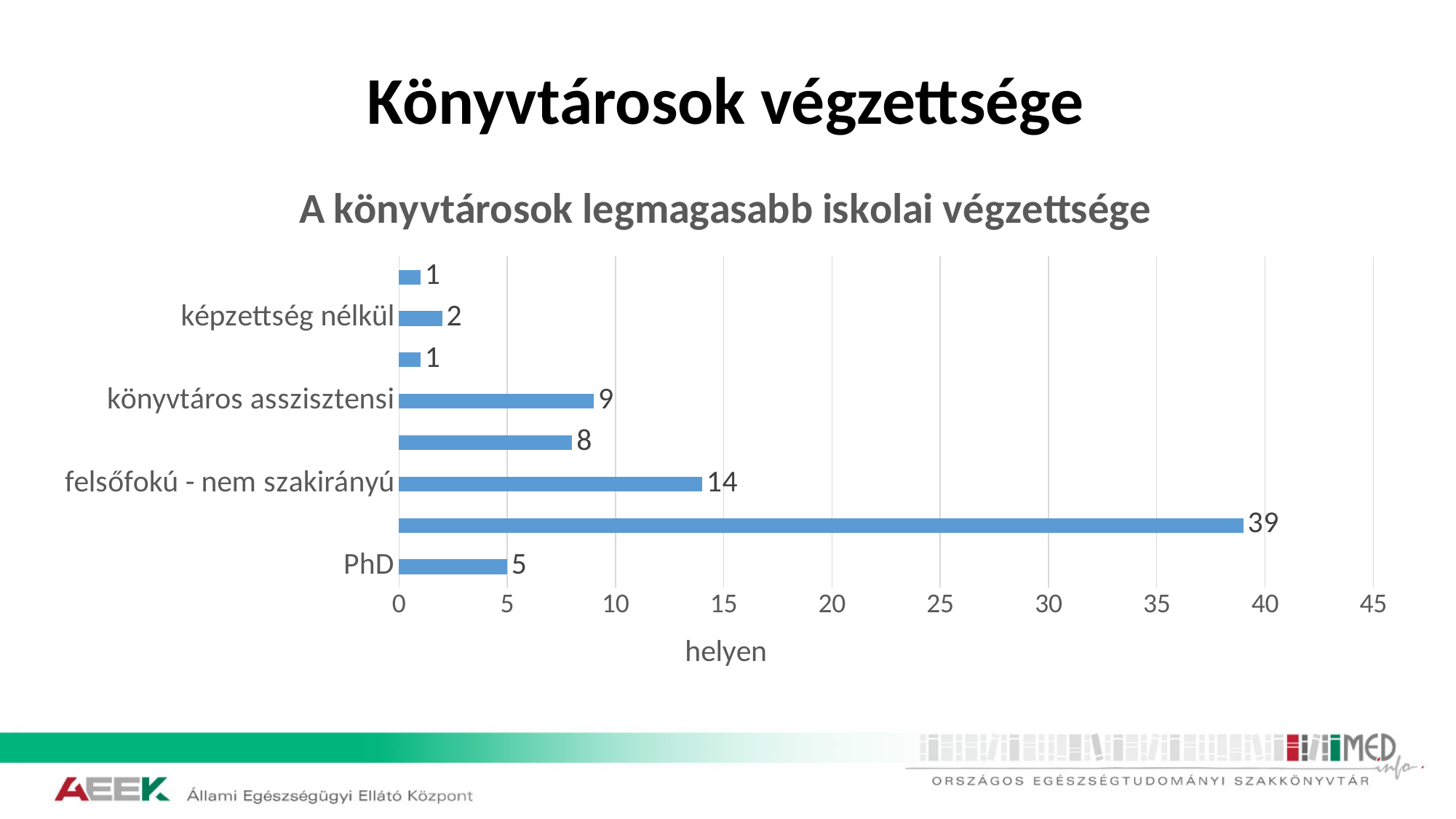
What is the value for könyvtáros asszisztensi? 9 Which is larger, the value for könyvtáros asszisztensi or the value for PhD? könyvtáros asszisztensi What is the title of the chart? A könyvtárosok legmagasabb iskolai végzettsége What is the difference between the values for felsőfokú - nem szakirányú and PhD? 9 What is the value for képzettség nélkül? 2 What is the value for PhD? 5 What is the value for felsőfokú - nem szakirányú? 14 What is the label of the horizontal axis? helyen Is the value for felsőfokú - nem szakirányú greater or less than 10? greater What type of chart is shown on the slide? bar chart What is the highest value shown in the chart? 39 How many bars are plotted in the chart? 8